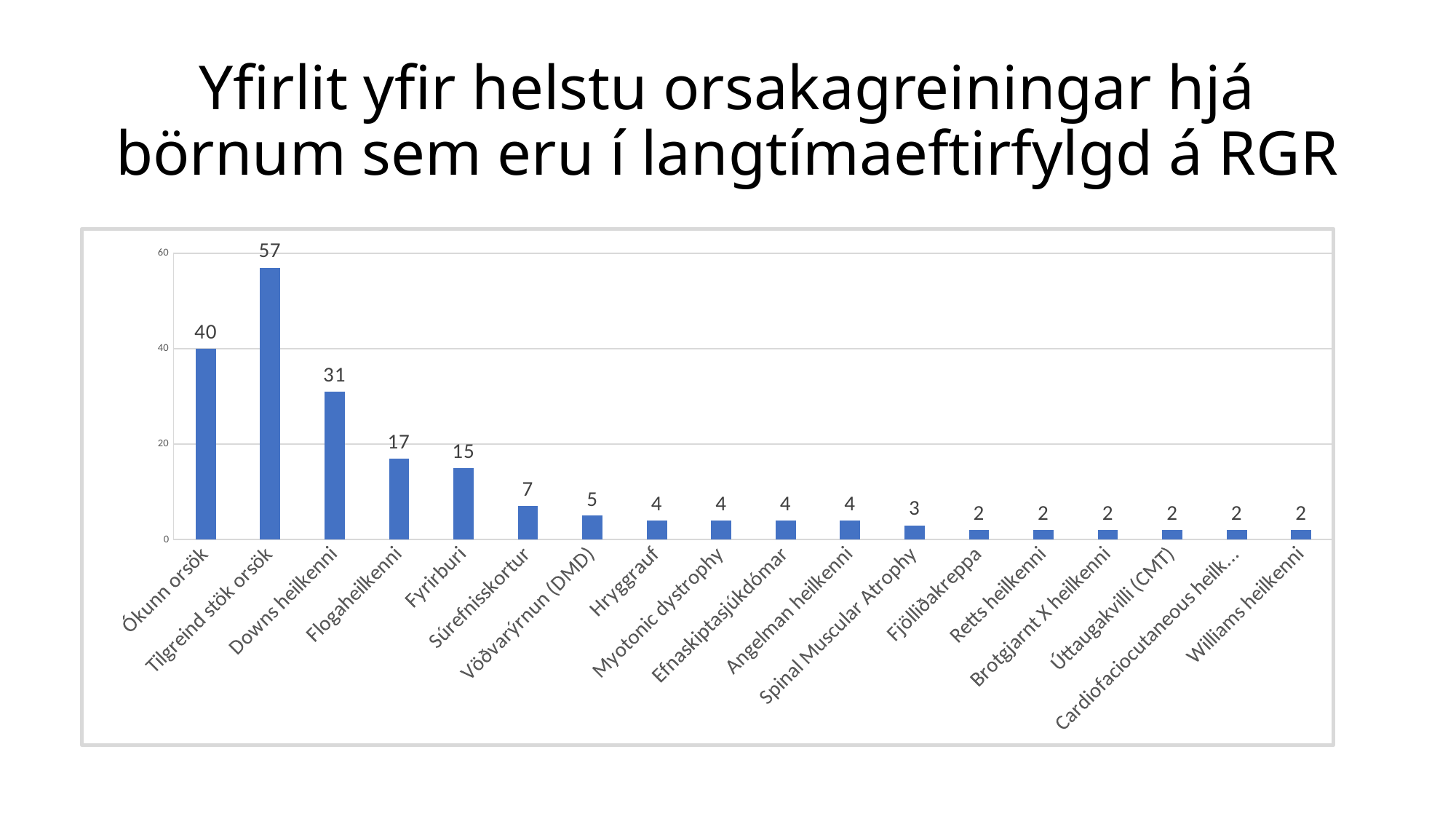
What is the difference between the values for Tilgreind stök orsök and Ókunn orsök? 17 What is the value for Tilgreind stök orsök? 57 Is the value for Ókunn orsök greater or less than 20? greater How many categories are shown on the x axis? 18 What kind of chart is shown on the slide? Bar chart What is the value for Downs heilkenni? 31 What is the value for Spinal Muscular Atrophy? 3 What is the value for Súrefnisskortur? 7 Which category has the highest value? Tilgreind stök orsök What is the value for Fyrirburi? 15 Which is larger, the value for Downs heilkenni or the value for Flogaheilkenni? Downs heilkenni What is the difference between the values for Flogaheilkenni and Fyrirburi? 2